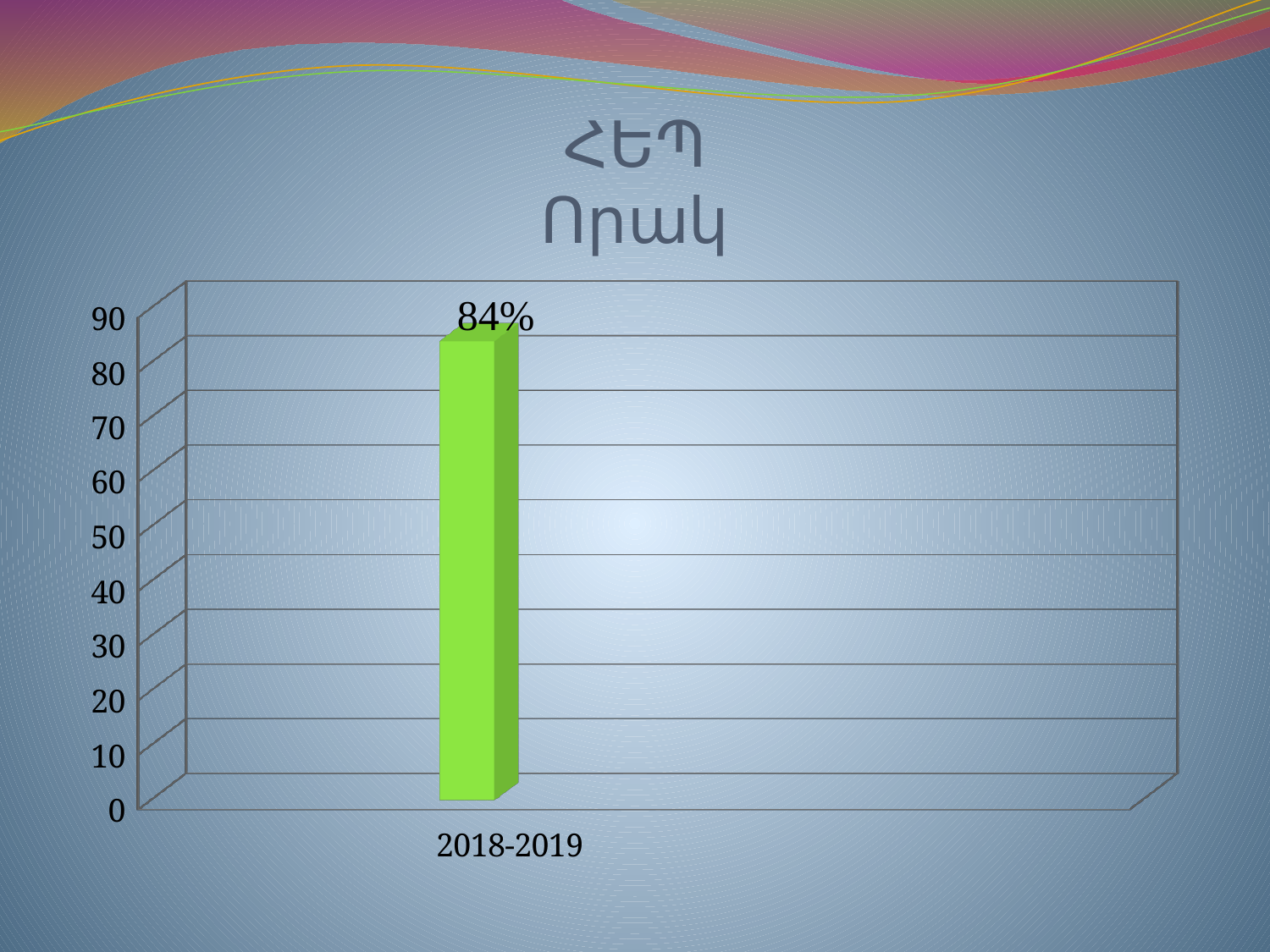
Is the value for 2018-2019 greater or less than 90? less What colour is the bar in the chart? green How many categories are plotted on the x axis? 1 Is the value for 2018-2019 greater or less than 80? greater What is the category label shown on the x axis? 2018-2019 What is the value shown for 2018-2019? 84% What kind of chart is shown on the slide? bar chart What is the highest value shown on the vertical axis? 90